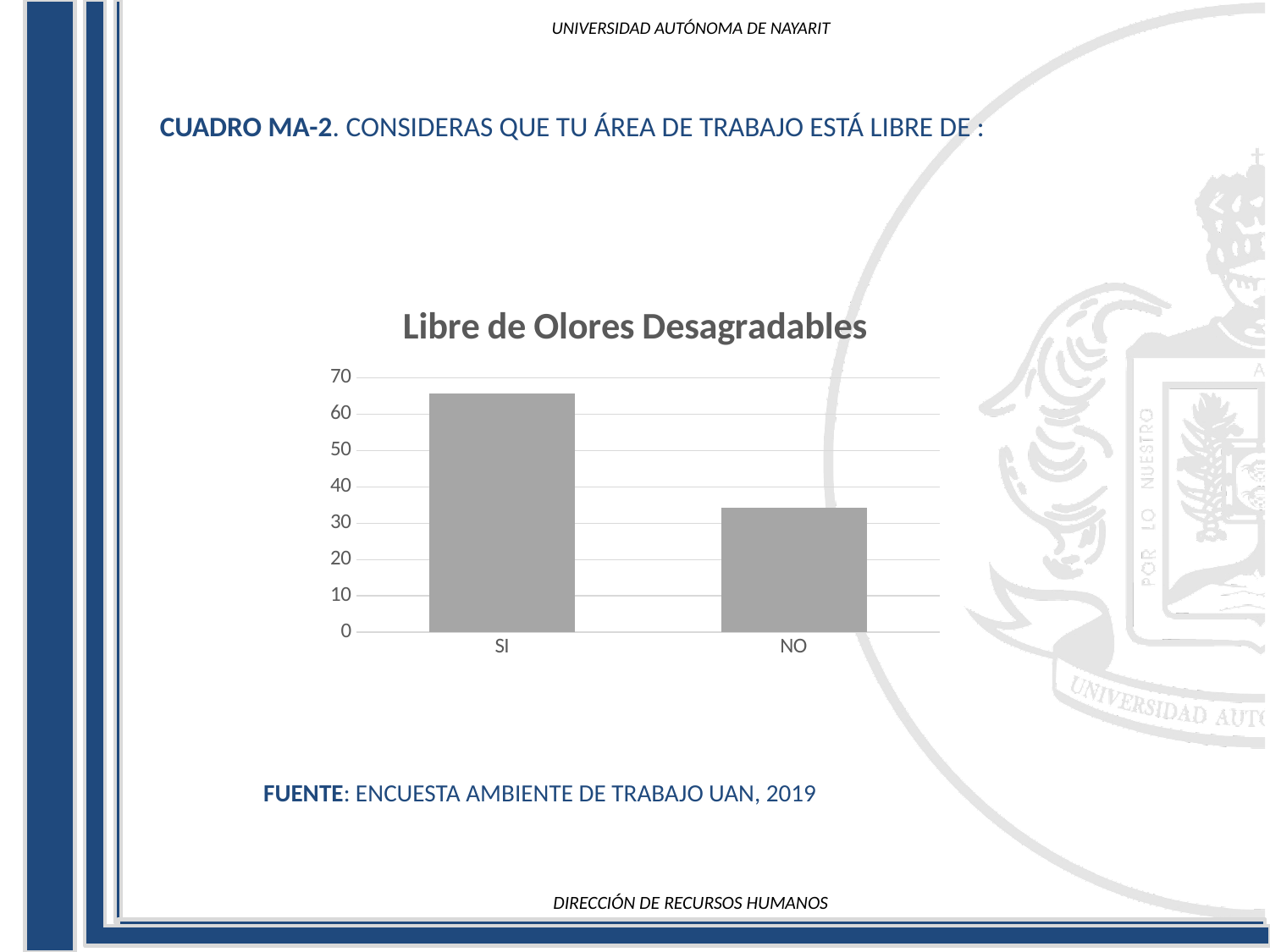
Is the value for SI greater or less than 60? greater What is the title of the chart? Libre de Olores Desagradables Do the values rise or fall from SI to NO along the x axis? fall What type of chart is shown on the slide? bar chart Is the value for SI greater or less than 70? less How many categories are shown on the x axis of the chart? 2 Which category has the lowest value in the chart? NO Which is larger, the value for SI or the value for NO? SI Is the value for NO greater or less than 30? greater What is the maximum value shown on the y axis of the chart? 70 Which category has the highest value in the chart? SI